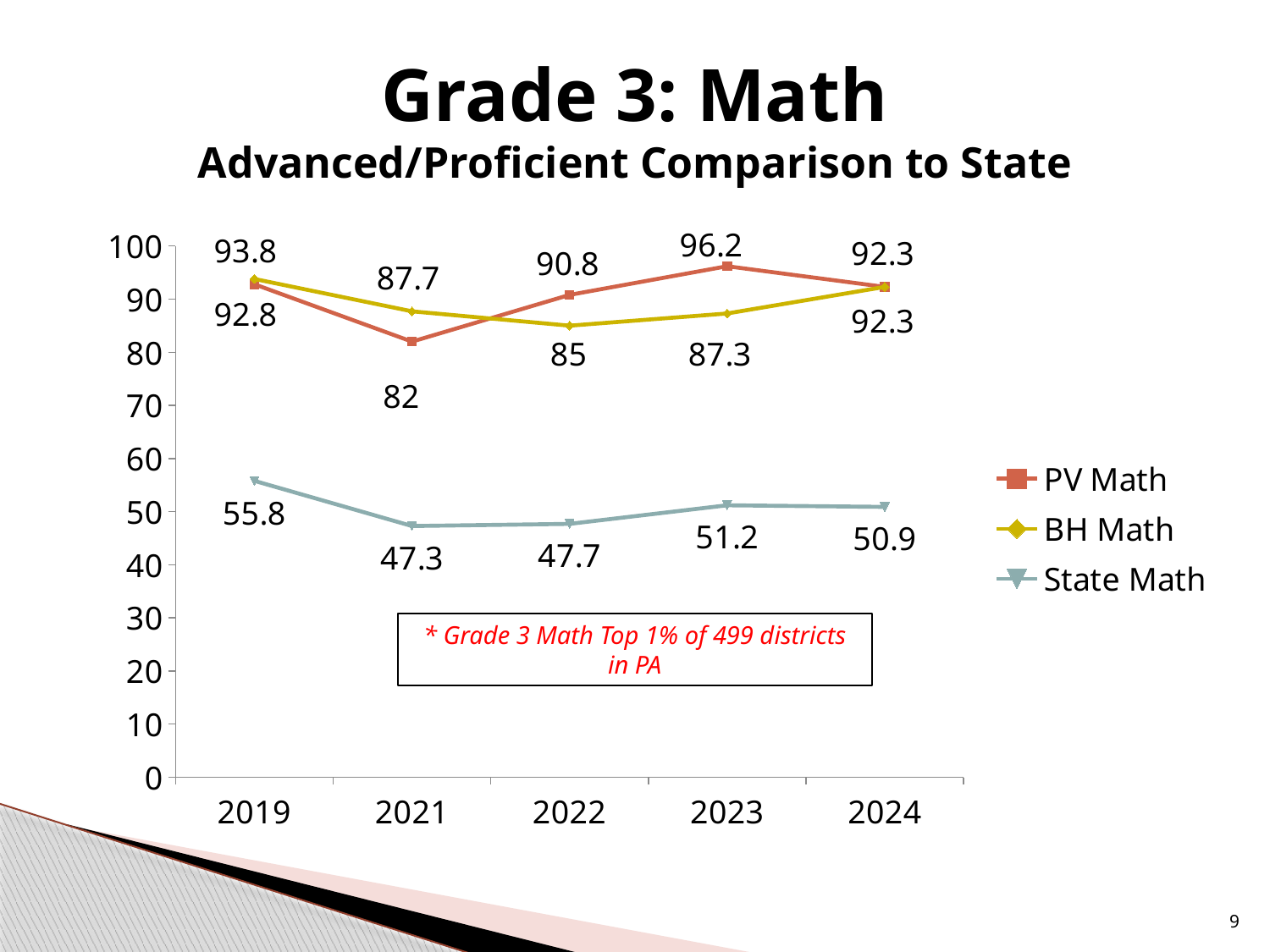
What is the difference between PV Math and State Math in 2024? 41.4 Which series is drawn in yellow? BH Math How many years are shown on the x axis? 5 What is the State Math value for 2021? 47.3 What is the PV Math value for 2023? 96.2 In which year is State Math at its highest? 2019 What type of chart is shown on the slide? line chart What is the BH Math value for 2022? 85 In which year is PV Math at its lowest? 2021 Which is larger in 2022, PV Math or BH Math? PV Math How many series does the legend list? 3 Does State Math rise or fall from 2019 to 2021? fall